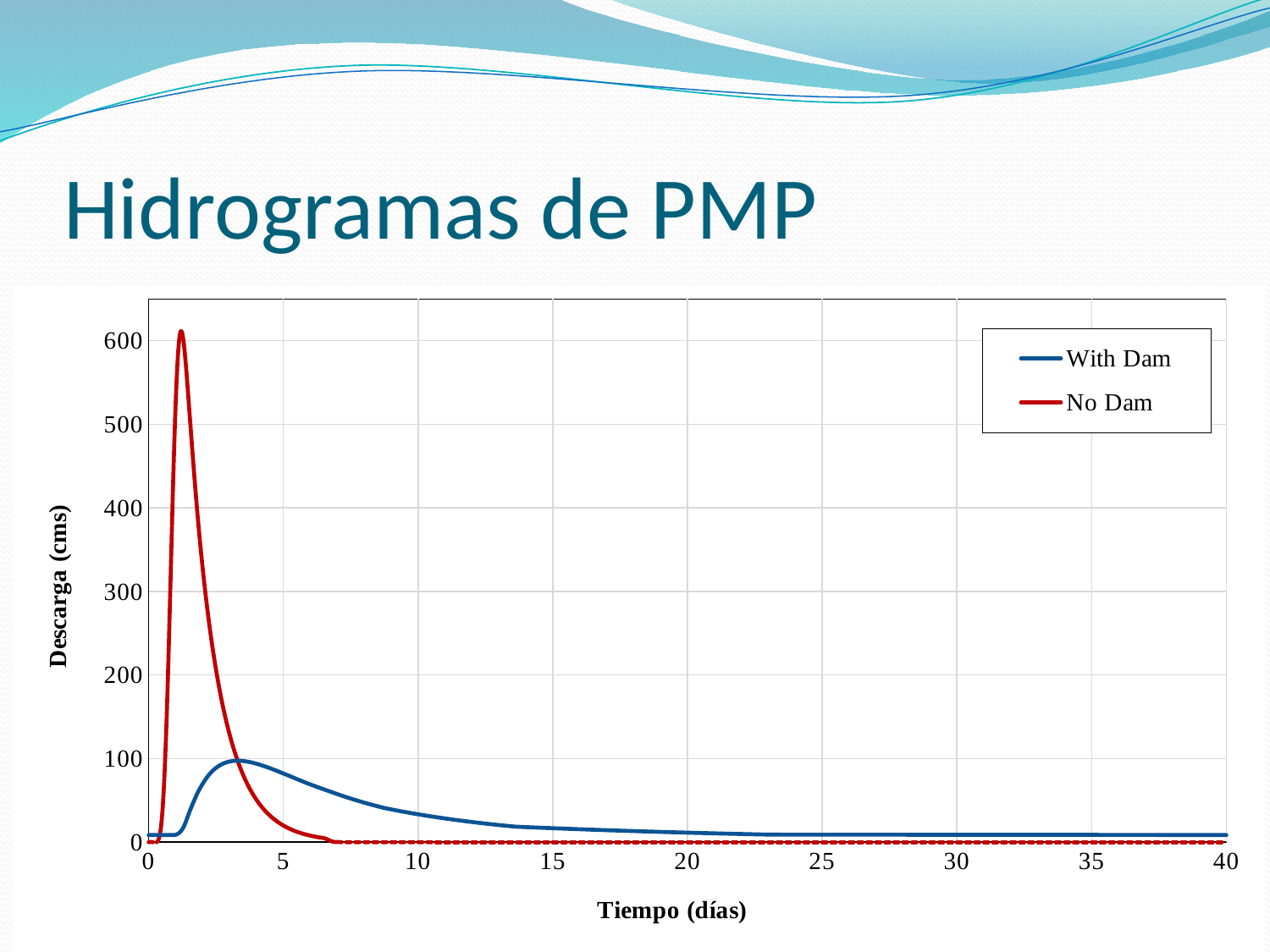
How many series does the legend list? 2 Is the value of the With Dam series at day 20 greater or less than 100? less Is the peak value of the With Dam series greater or less than 200? less What is the title of the y axis? Descarga (cms) What are the two series named in the legend? With Dam and No Dam Is the value of the No Dam series at day 10 greater or less than 100? less After its peak, does the No Dam series rise or fall as time increases? fall What is the highest tick value shown on the x axis? 40 Which series peaks earlier in time, With Dam or No Dam? No Dam Which series reaches the higher peak discharge, With Dam or No Dam? No Dam What kind of chart is shown on the slide? Line chart